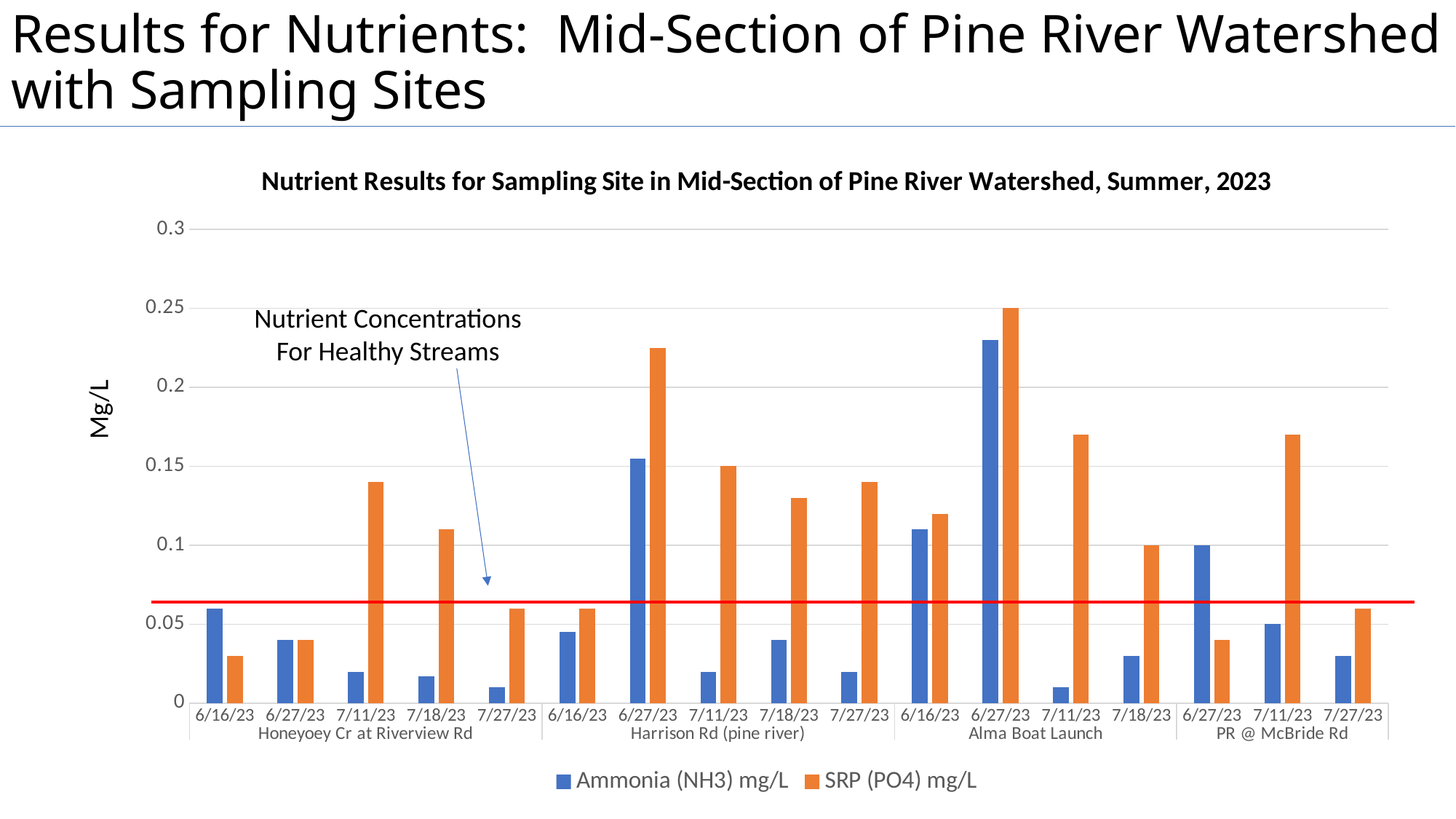
How many sampling sites are shown along the x axis? 4 What is the SRP (PO4) mg/L value at Alma Boat Launch on 6/27/23? 0.25 At Alma Boat Launch on 7/11/23, which is larger, Ammonia (NH3) mg/L or SRP (PO4) mg/L? SRP (PO4) mg/L What kind of chart is shown on the slide? bar chart How many sampling dates are shown for Harrison Rd (pine river)? 5 Is the Ammonia (NH3) mg/L value at Alma Boat Launch on 6/27/23 greater or less than 0.2? greater Is the SRP (PO4) mg/L value at Honeyoey Cr at Riverview Rd on 7/11/23 greater or less than 0.15? less How many series does the legend list? 2 What does the red horizontal line on the chart represent? Nutrient Concentrations For Healthy Streams What is the SRP (PO4) mg/L value at Harrison Rd (pine river) on 7/11/23? 0.15 Which colour represents SRP (PO4) mg/L in the chart? orange Which site and date has the highest SRP (PO4) mg/L value? Alma Boat Launch, 6/27/23